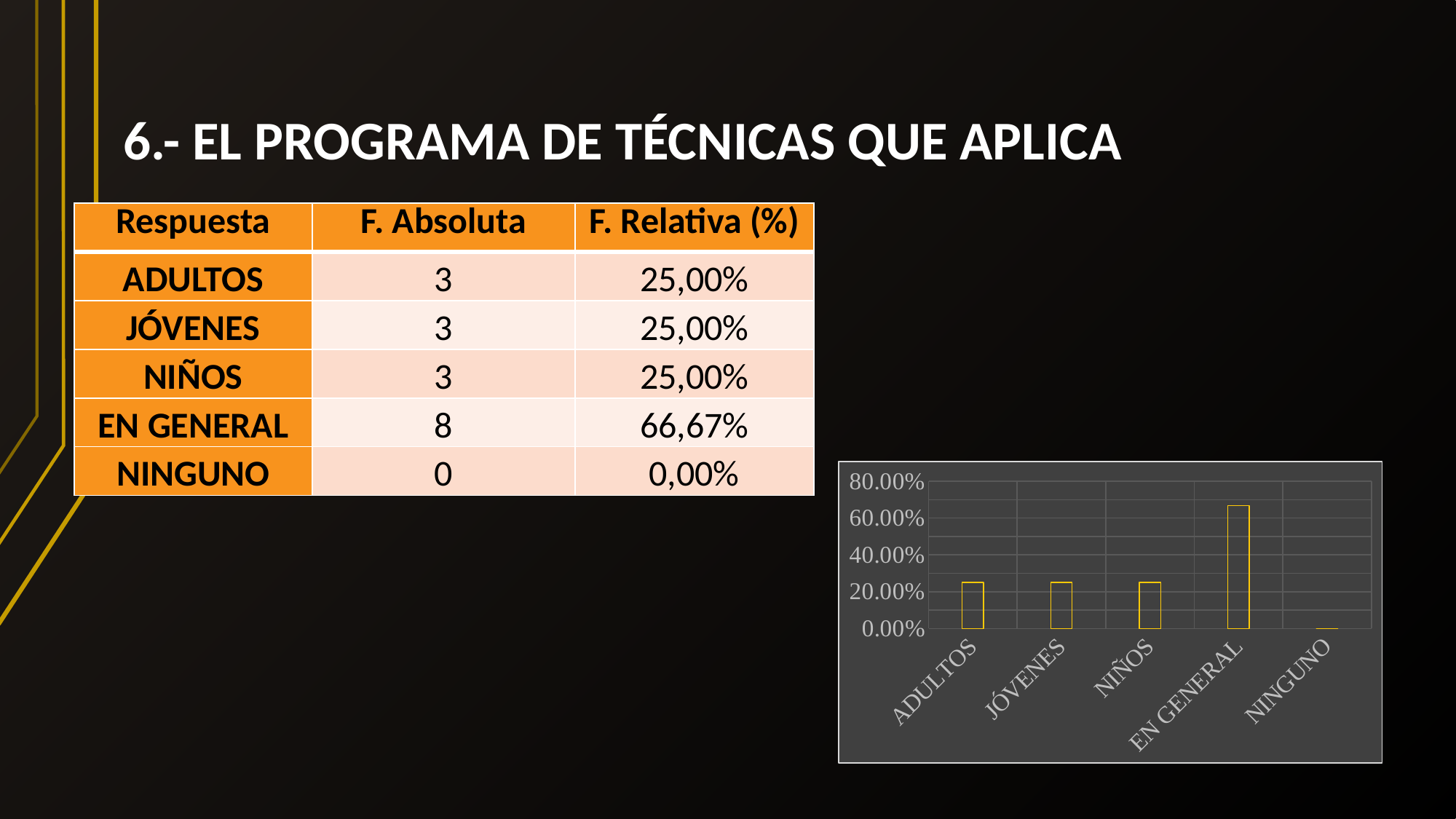
How many categories are shown on the x axis of the chart? 5 What kind of chart is shown on the slide? bar chart Is the value for EN GENERAL greater or less than 60.00%? greater What is the difference in absolute frequency between EN GENERAL and ADULTOS? 5 According to the slide, what is the relative frequency (F. Relativa) for JÓVENES? 25,00% According to the slide, what is the relative frequency (F. Relativa) for EN GENERAL? 66,67% Which is larger in the chart, the value for EN GENERAL or the value for NIÑOS? EN GENERAL What is the highest tick value shown on the chart's vertical axis? 80.00% According to the slide, what is the absolute frequency (F. Absoluta) for NINGUNO? 0 Which category has the highest bar in the chart? EN GENERAL Is the value for ADULTOS greater or less than 40.00%? less Which category has the lowest value in the chart? NINGUNO